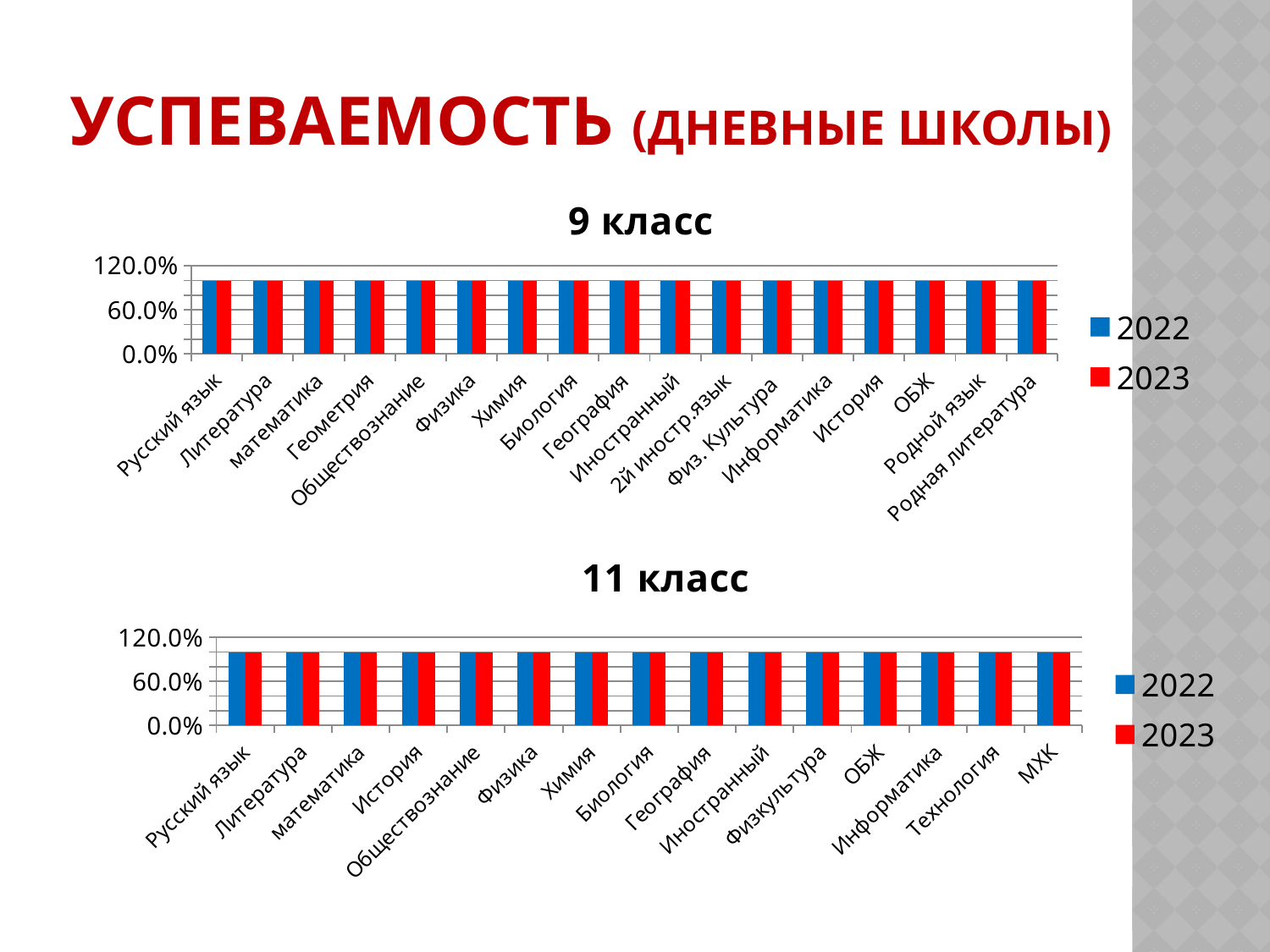
In the "11 класс" chart, do the 2023 values rise, fall, or stay roughly flat across the subjects on the x axis? stay roughly flat How many subject categories are shown on the x axis of the "9 класс" chart? 17 How many series does the legend of the "11 класс" chart list? 2 What kind of chart is the "11 класс" chart? bar chart Which years are listed in the legend of the "11 класс" chart? 2022 and 2023 In the "9 класс" chart, is the 2023 value for Физика greater or less than 60.0%? greater What kind of chart is the "9 класс" chart? bar chart In the "9 класс" chart, is the 2022 value for Геометрия greater or less than 120.0%? less How many subject categories are shown on the x axis of the "11 класс" chart? 15 What colour represents the 2023 series in the "9 класс" chart? red How many series does the legend of the "9 класс" chart list? 2 In the "11 класс" chart, is the 2022 value for МХК greater or less than 60.0%? greater